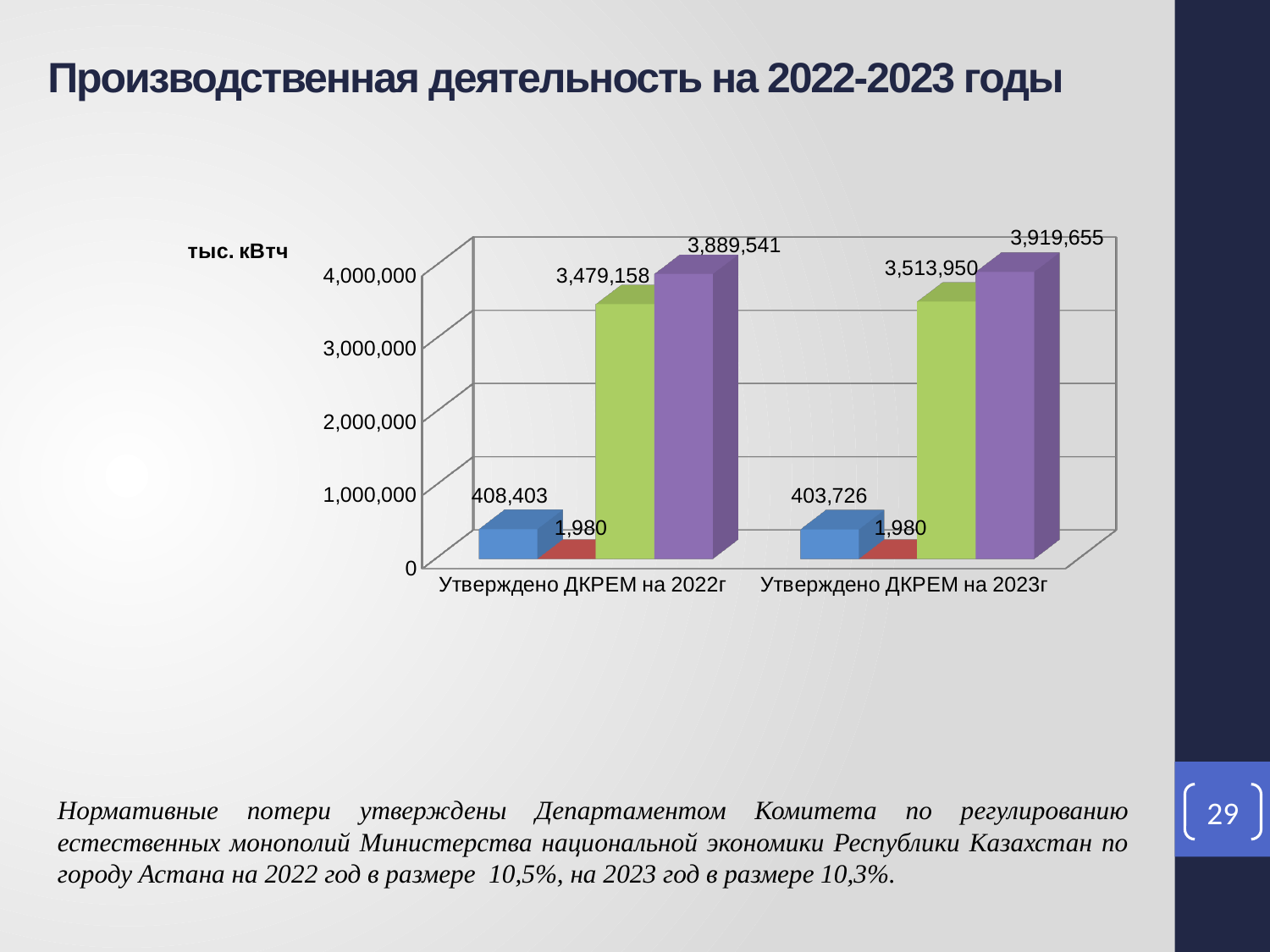
What is the value of the purple bar for "Утверждено ДКРЕМ на 2022г"? 3,889,541 Is the value of the green bar for "Утверждено ДКРЕМ на 2023г" greater or less than 3,000,000? greater How many categories are shown on the x axis of the chart? 2 What is the value of the red bar for "Утверждено ДКРЕМ на 2022г"? 1,980 What type of chart is shown on the slide? bar chart What is the value of the green bar for "Утверждено ДКРЕМ на 2022г"? 3,479,158 What unit is indicated above the vertical axis of the chart? тыс. кВтч What is the value of the purple bar for "Утверждено ДКРЕМ на 2023г"? 3,919,655 What is the value of the blue bar for "Утверждено ДКРЕМ на 2023г"? 403,726 Which category has the higher value for the green bar, "Утверждено ДКРЕМ на 2022г" or "Утверждено ДКРЕМ на 2023г"? Утверждено ДКРЕМ на 2023г What is the difference between the blue bar values for 2022 (408,403) and 2023 (403,726)? 4,677 What is the difference between the purple bar values for 2023 (3,919,655) and 2022 (3,889,541)? 30,114